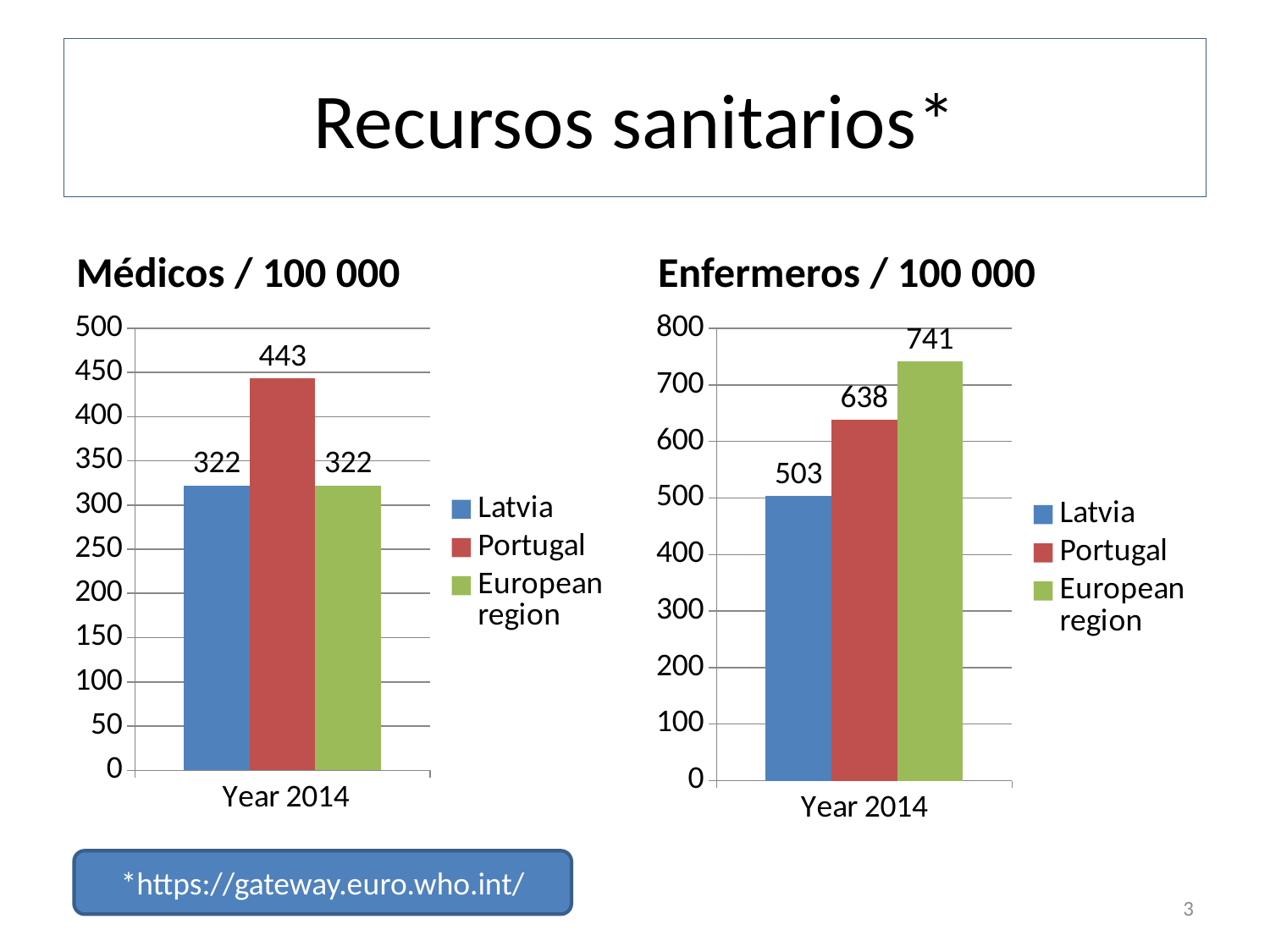
In the 'Médicos / 100 000' chart, what is the value for Portugal? 443 In the 'Enfermeros / 100 000' chart, what is the value for Latvia? 503 In the 'Enfermeros / 100 000' chart, which is larger, Portugal or Latvia? Portugal In the 'Médicos / 100 000' chart, which series has the highest value? Portugal In the 'Médicos / 100 000' chart, what is the value for Latvia? 322 In the 'Enfermeros / 100 000' chart, what is the difference between the European region and Portugal? 103 In the 'Enfermeros / 100 000' chart, which series has the highest value? European region In the 'Enfermeros / 100 000' chart, which series has the lowest value? Latvia How many series does the legend of the 'Médicos / 100 000' chart list? 3 What kind of chart is the 'Enfermeros / 100 000' chart? Bar chart In the 'Médicos / 100 000' chart, what is the difference between Portugal and Latvia? 121 In the 'Enfermeros / 100 000' chart, what is the value for the European region? 741